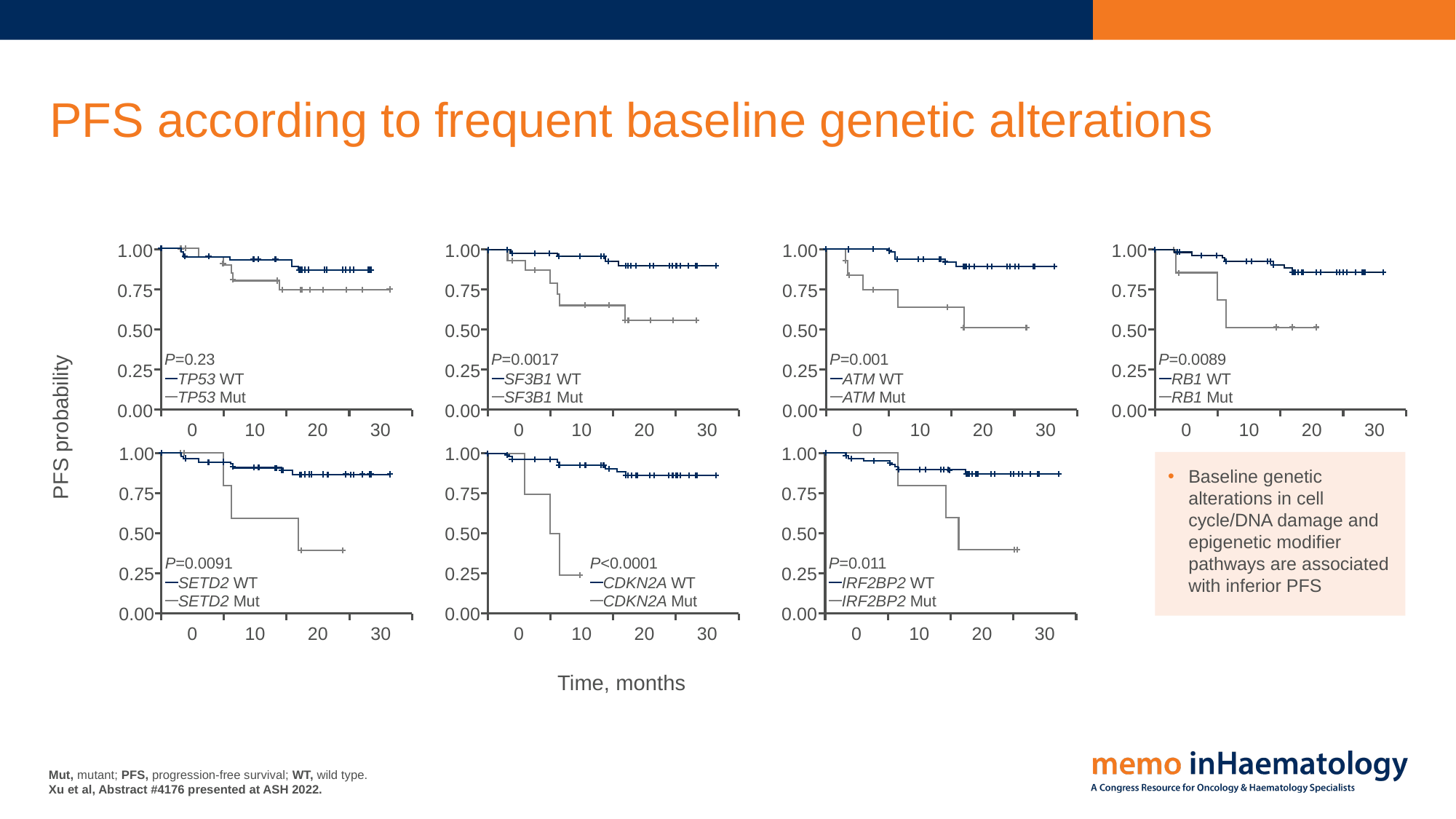
In the RB1 plot, does the RB1 Mut curve rise or fall over time? fall In the TP53 plot, how many series does the legend list? 2 In the CDKN2A plot, which curve ends at a higher PFS probability, CDKN2A WT or CDKN2A Mut? CDKN2A WT What is the label of the shared x axis? Time, months What P value is printed in the TP53 plot? P=0.23 What P value is printed in the CDKN2A plot? P<0.0001 What is the label of the shared y axis? PFS probability What kind of chart is used in each panel of the slide? Line chart (Kaplan-Meier survival curve) How many Kaplan-Meier plots are shown on the slide? 7 In the SETD2 plot, is the final PFS probability for SETD2 Mut greater or less than 0.50? less In the ATM plot, is the final PFS probability for ATM WT greater or less than 0.75? greater What P value is printed in the SF3B1 plot? P=0.0017